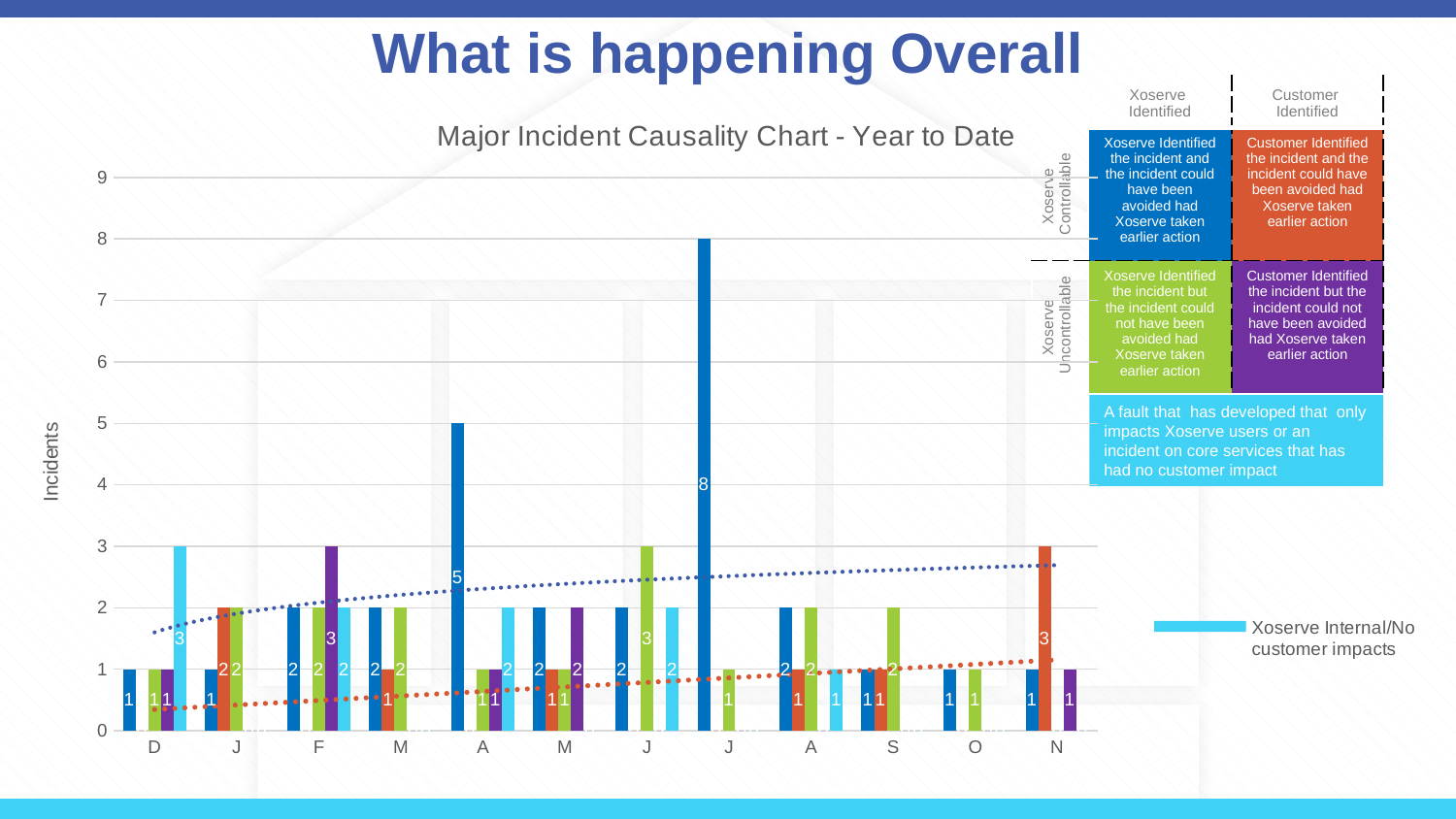
What kind of chart is shown on the slide? bar chart What is the value of the tallest dark blue bar in the month labelled A (April)? 5 Is the tallest bar in the chart greater or less than 7? greater How many month categories are shown along the x axis of the chart? 12 What is the highest tick value shown on the vertical axis? 9 What is the title of the chart? Major Incident Causality Chart - Year to Date What is the value of the light blue bar in the month labelled D? 3 What is the highest value labelled on any bar in the chart? 8 Which is larger: the tallest bar in the month labelled A (April) or the tallest bar in the month labelled D? A (April) What is the difference between the tallest bar (8) and the dark blue bar of 5 in April? 3 What is the label on the vertical axis of the chart? Incidents What is the value of the orange bar in the month labelled N? 3